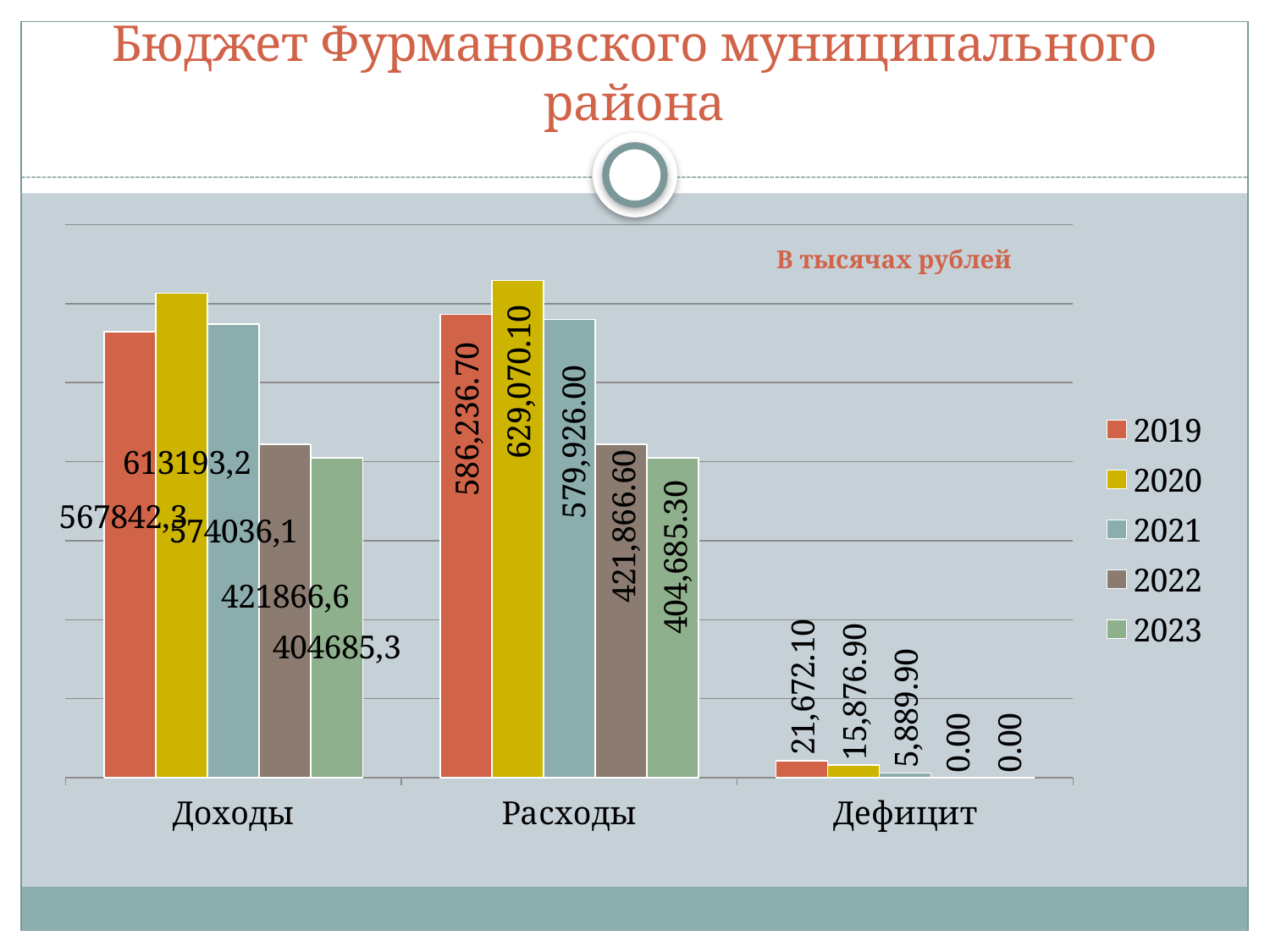
How many categories are shown on the x axis? 3 What type of chart is shown on the slide? bar chart Which is larger in the Дефицит category: the value for 2020 or the value for 2021? 2020 What is the difference between the 2020 and 2019 values in the Расходы category? 42,833.40 Which year has the lowest value in the Доходы category? 2023 What is the value for 2023 in the Доходы category? 404685,3 What is the value for 2021 in the Расходы category? 579,926.00 What is the value for 2019 in the Дефицит category? 21,672.10 What is the value for 2020 in the Доходы category? 613193,2 How many series does the legend list? 5 What unit is stated for the values on the chart? В тысячах рублей Which year has the highest value in the Расходы category? 2020